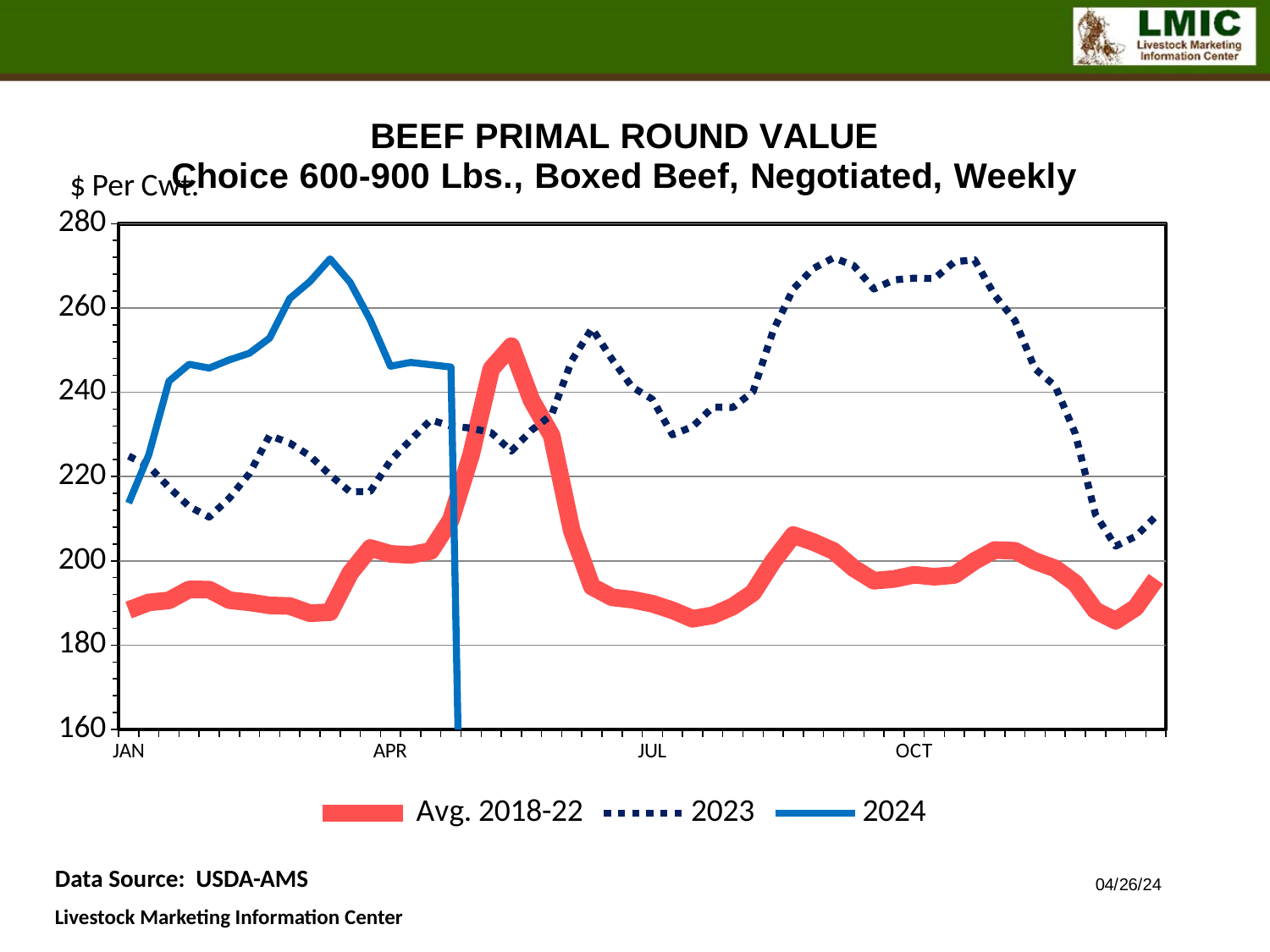
What unit is shown on the y-axis label? $ Per Cwt. Is the value of the Avg. 2018-22 line at JAN greater or less than 200? less Does the 2024 line rise or fall from JAN to early March? rise Which series has the lowest value at JAN? Avg. 2018-22 Is the value of the 2024 line at JAN greater or less than 220? less At JAN, which series has the higher value: 2023 or Avg. 2018-22? 2023 What kind of chart is shown on the slide? line chart How many series does the legend list? 3 Is the highest value of the Avg. 2018-22 line greater or less than 240? greater What is the title of the chart? BEEF PRIMAL ROUND VALUE